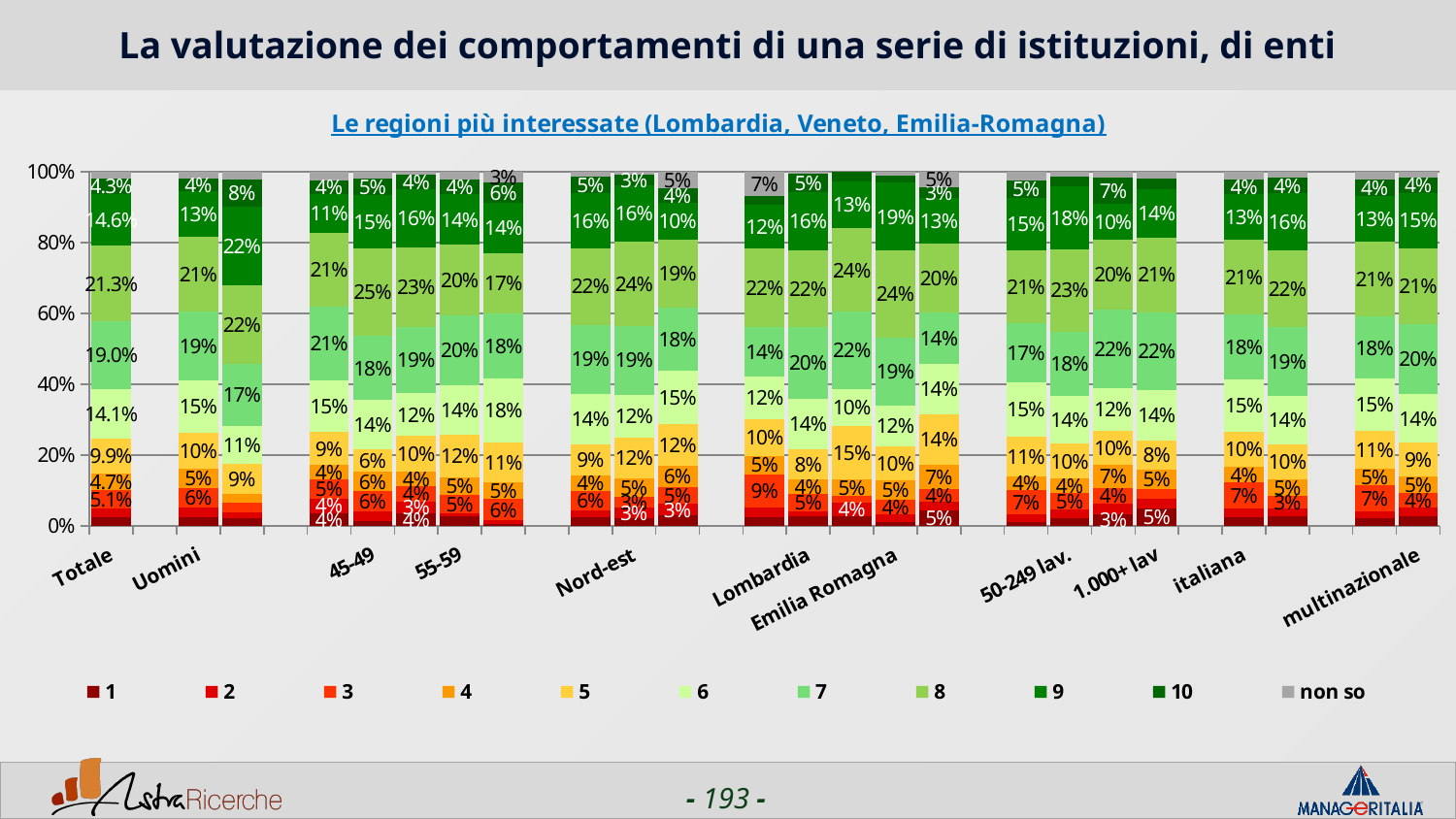
What is the share of rating 10 in the Totale bar? 4.3% Which rating has the largest share in the Totale bar? 8 What is the share of rating 10 in the Uomini bar? 4% What is the subtitle shown above the chart? Le regioni più interessate (Lombardia, Veneto, Emilia-Romagna) What is the share of rating 9 in the Totale bar? 14.6% What is the label of the last legend entry, after the ratings 1 to 10? non so How many series does the legend list? 11 What kind of chart is shown on the slide? Stacked bar chart